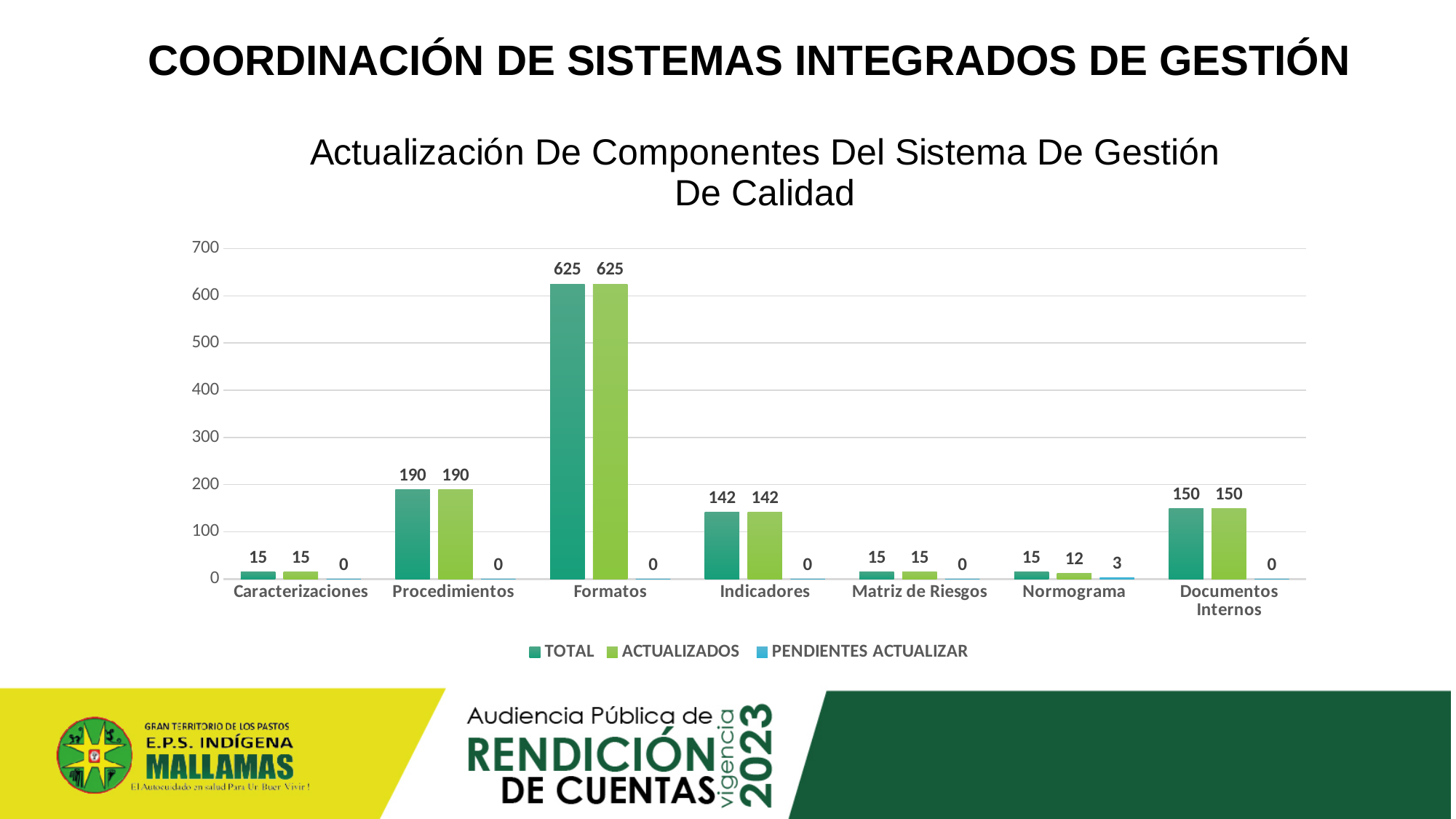
What is the TOTAL value for Formatos? 625 What is the ACTUALIZADOS value for Normograma? 12 What is the difference between the TOTAL and ACTUALIZADOS values for Normograma? 3 What kind of chart is shown on the slide? Bar chart How many categories are shown on the x axis? 7 Which is larger, the TOTAL value for Documentos Internos or the TOTAL value for Indicadores? Documentos Internos What is the PENDIENTES ACTUALIZAR value for Normograma? 3 Which category has the highest PENDIENTES ACTUALIZAR value? Normograma How many series does the legend list? 3 What is the difference between the TOTAL values for Procedimientos and Indicadores? 48 Which category has the highest TOTAL value? Formatos What is the TOTAL value for Documentos Internos? 150